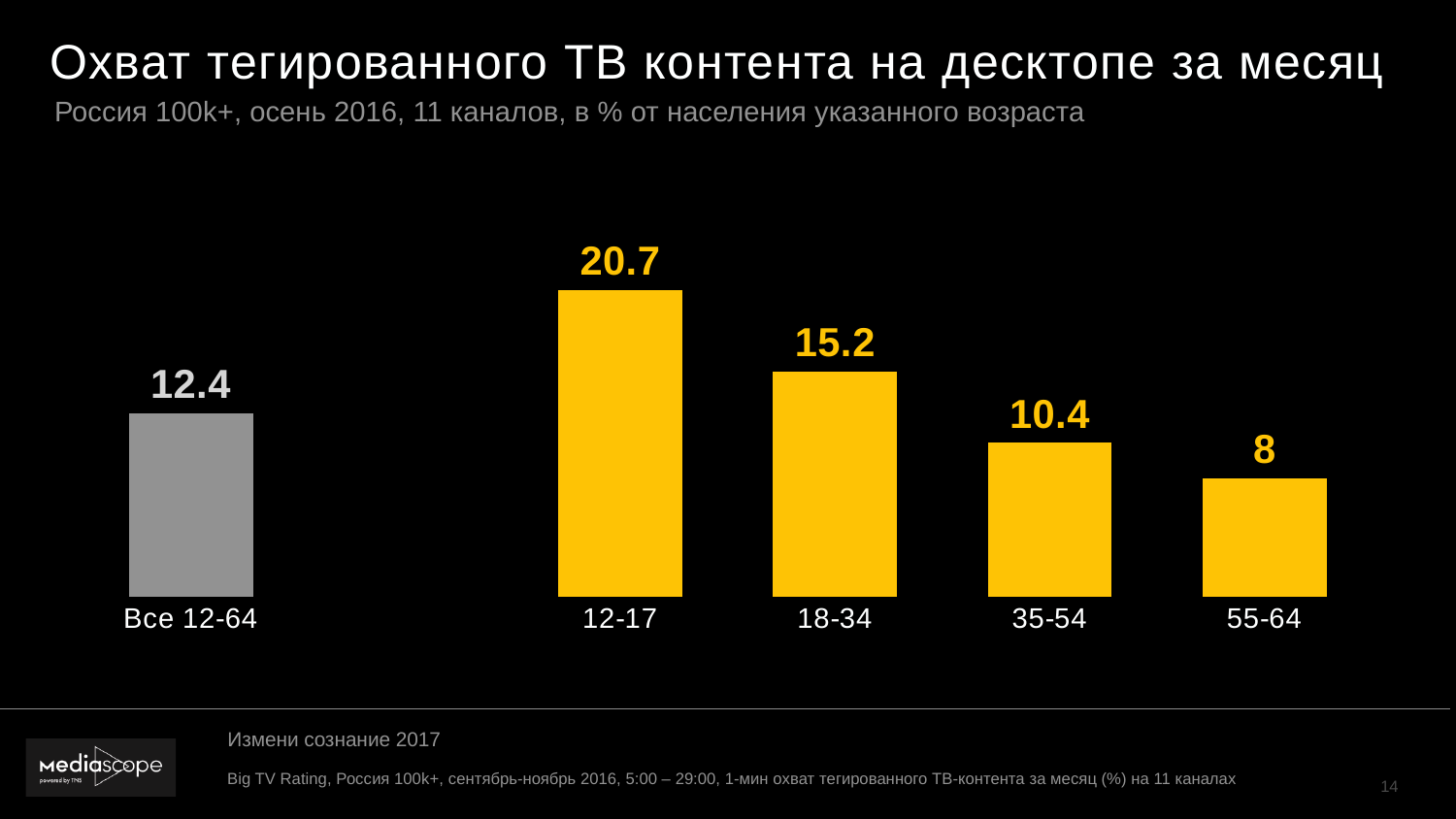
Which is larger, the value for 18-34 or the value for 35-54? 18-34 What is the value for the 35-54 age group? 10.4 What is the difference between the values for 12-17 and 18-34? 5.5 What kind of chart is shown on the slide? Bar chart Do the values rise or fall across the age groups from 12-17 to 55-64? Fall What is the difference between the values for 'Все 12-64' and 55-64? 4.4 How many bars are shown in the chart? 5 What is the value for the 12-17 age group? 20.7 What is the value for the 55-64 age group? 8 Which category has the lowest value? 55-64 Which age group has the highest value? 12-17 What is the value for the 'Все 12-64' category? 12.4